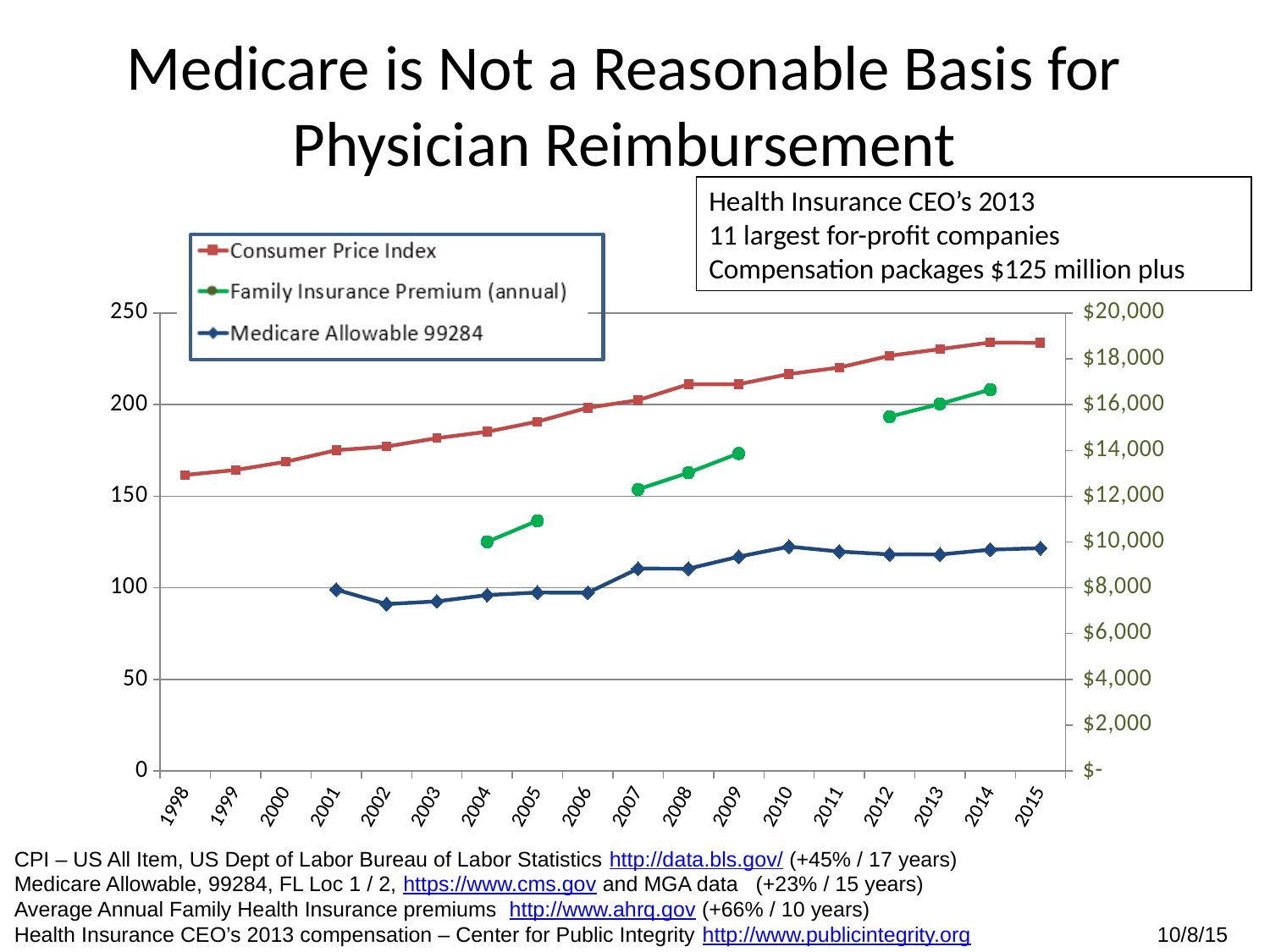
Which series in the chart is drawn in green? Family Insurance Premium (annual) Is the Consumer Price Index value for 2015 greater or less than 200? greater Is the Medicare Allowable 99284 value for 2010 greater or less than 100? greater In 2015, which is larger on the left axis: the Consumer Price Index or the Medicare Allowable 99284? Consumer Price Index Is the Medicare Allowable 99284 value for 2002 greater or less than 100? less Does the Consumer Price Index rise or fall from 1998 to 2015? rise How many years are shown on the x axis of the chart? 18 How many series does the chart legend list? 3 Which year has the lowest Consumer Price Index value on the chart? 1998 What kind of chart is shown on the slide? line chart